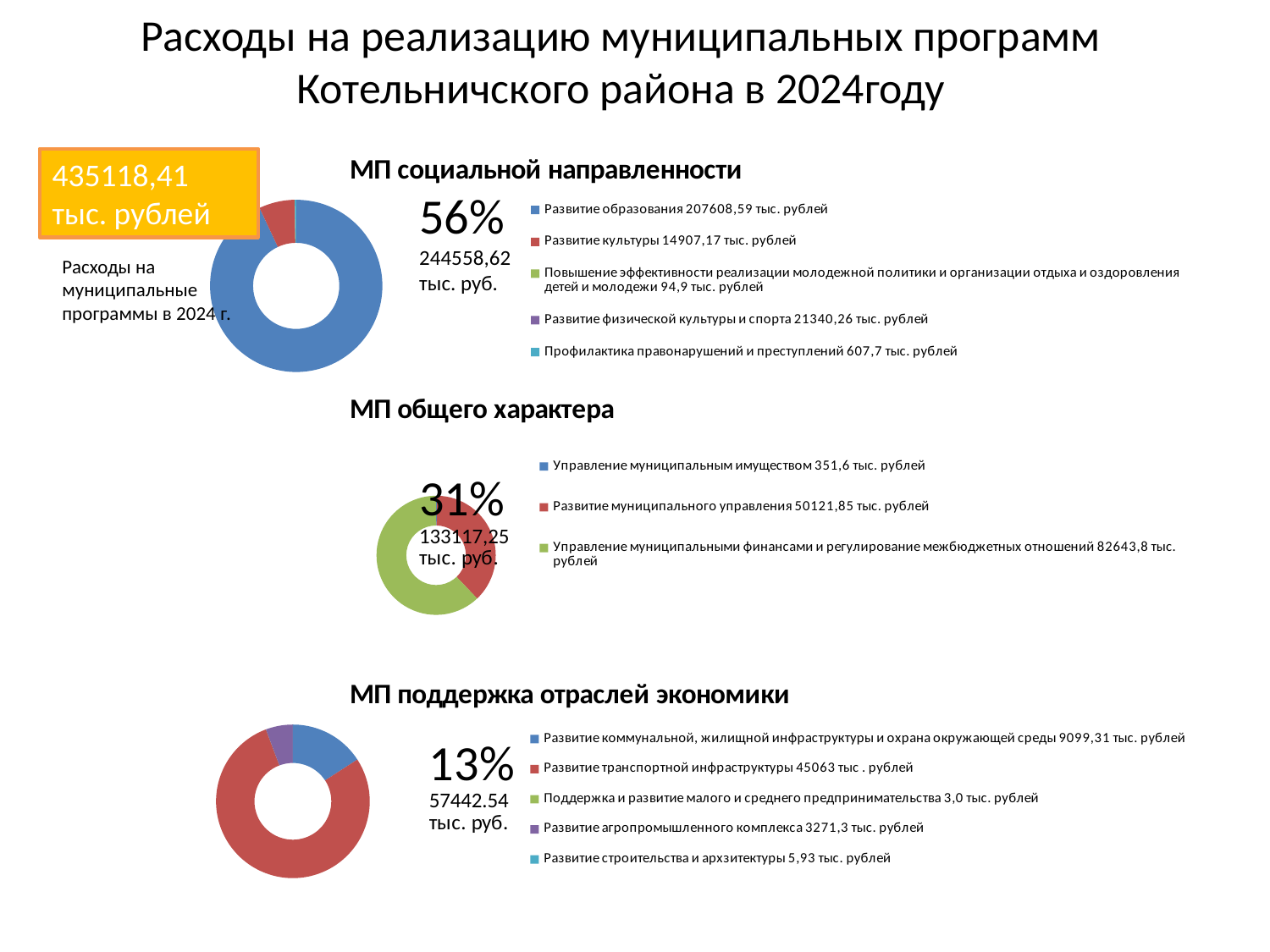
How many categories does the legend of the "МП социальной направленности" chart list? 5 In the "МП поддержка отраслей экономики" chart, which category has the smallest value? Поддержка и развитие малого и среднего предпринимательства How many categories does the legend of the "МП общего характера" chart list? 3 In the "МП общего характера" chart, what is the value for "Развитие муниципального управления"? 50121,85 тыс. рублей In the "МП социальной направленности" chart, what is the value for "Развитие образования"? 207608,59 тыс. рублей What kind of chart is used for "МП социальной направленности"? doughnut (pie) chart In the "МП общего характера" chart, which category has the largest value? Управление муниципальными финансами и регулирование межбюджетных отношений In the "МП социальной направленности" chart, which is larger: "Развитие культуры" or "Развитие физической культуры и спорта"? Развитие физической культуры и спорта What percentage is shown next to the "МП поддержка отраслей экономики" chart? 13% In the "МП общего характера" chart, what is the difference between "Управление муниципальными финансами и регулирование межбюджетных отношений" and "Развитие муниципального управления"? 32521,95 тыс. рублей In the "МП социальной направленности" chart, which category has the smallest value? Повышение эффективности реализации молодежной политики и организации отдыха и оздоровления детей и молодежи In the "МП поддержка отраслей экономики" chart, what is the value for "Развитие транспортной инфраструктуры"? 45063 тыс. рублей